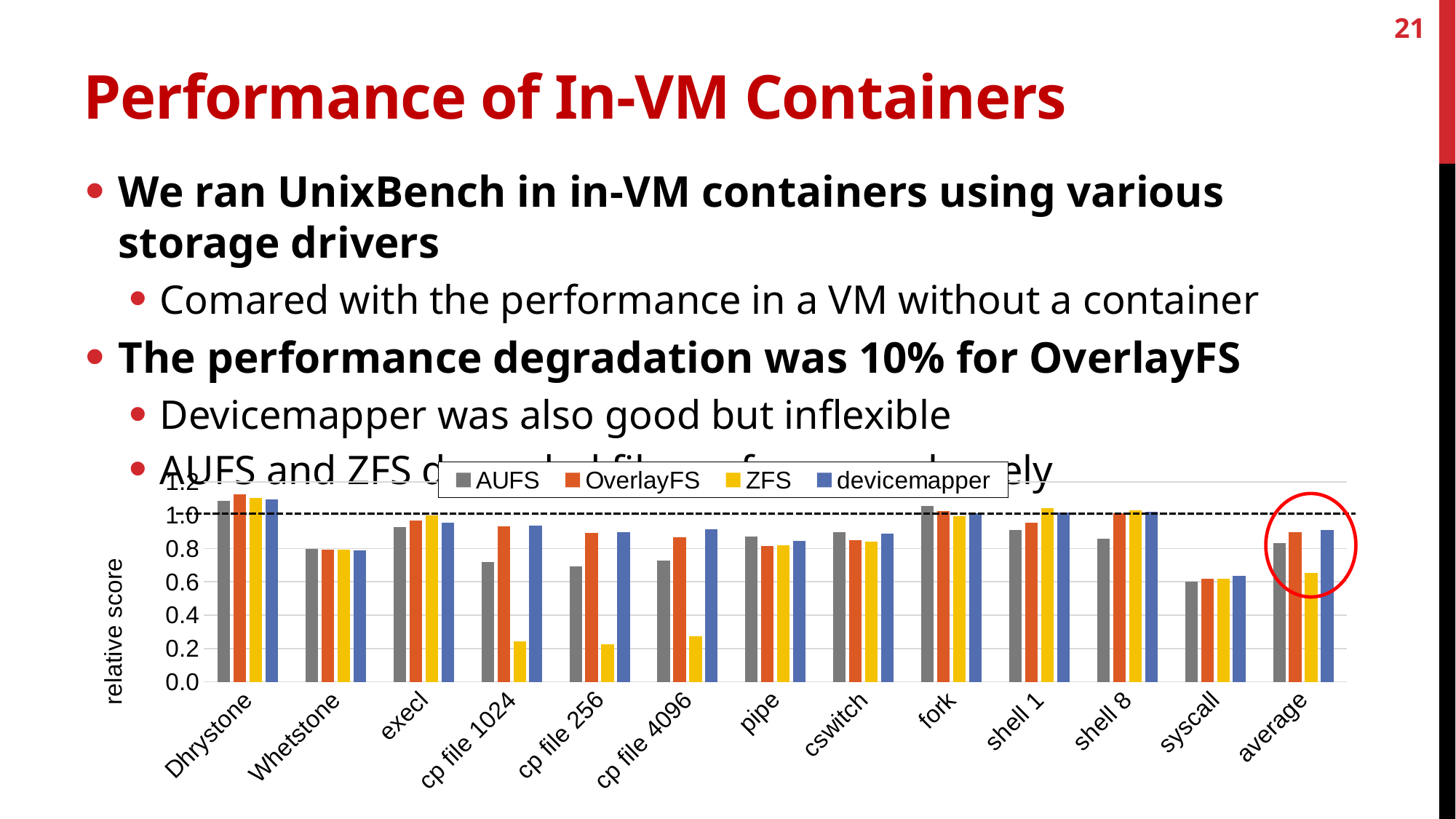
Is the OverlayFS value for Dhrystone greater or less than 1.0? greater For cp file 1024, which is larger: the OverlayFS value or the ZFS value? OverlayFS How many benchmark categories are shown along the x axis of the chart? 13 Is the ZFS value for cp file 1024 greater or less than 0.4? less Is the ZFS value for average greater or less than 0.8? less In which category is the AUFS value lowest? syscall For cp file 4096, which series has the lowest value? ZFS What is the label of the y axis of the chart? relative score How many series does the chart legend list? 4 What kind of chart is shown on the slide? bar chart